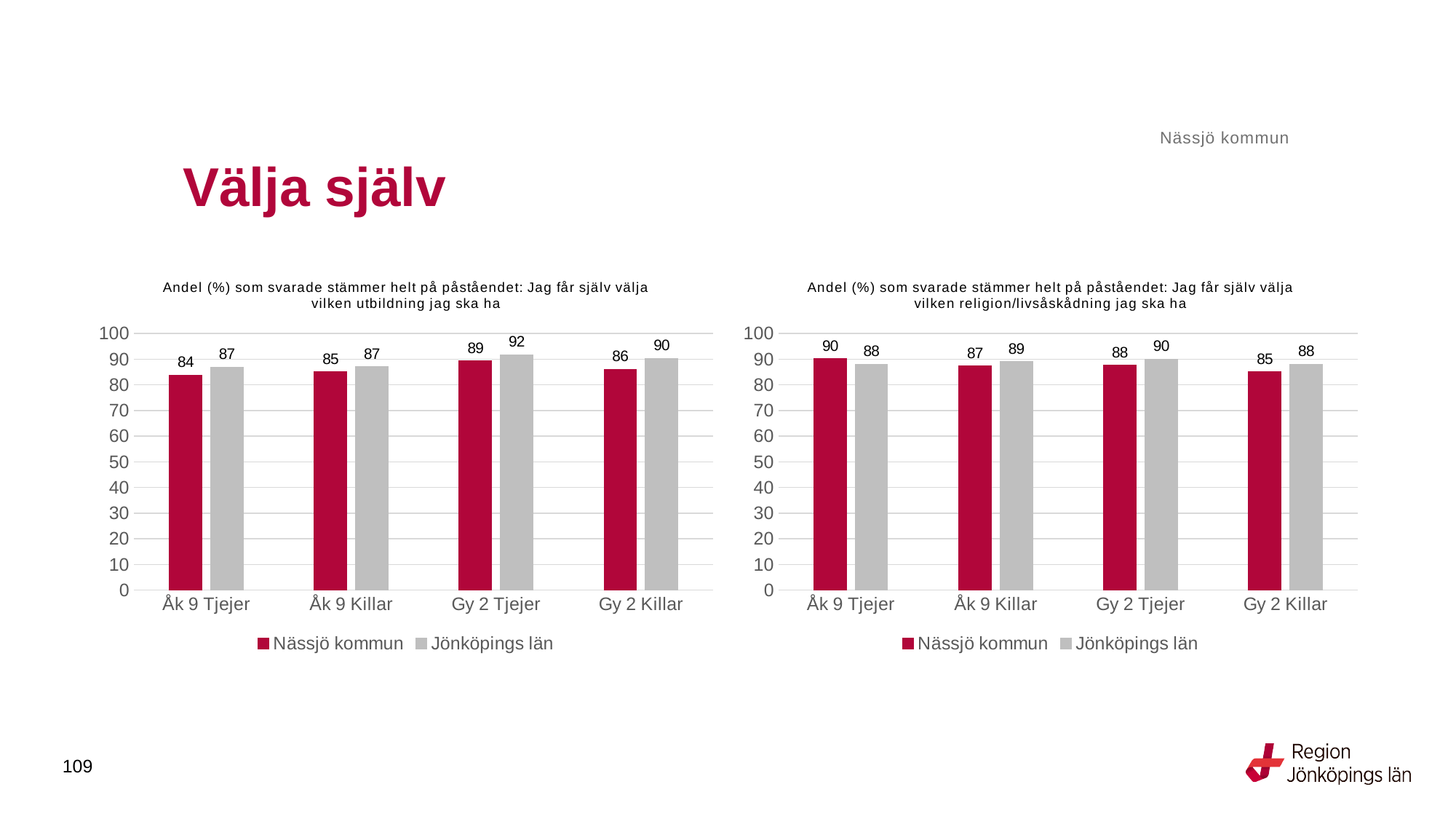
In the right chart (about choosing religion), what is the value for Nässjö kommun for Åk 9 Tjejer? 90 In the right chart (about choosing religion), what is the value for Jönköpings län for Gy 2 Killar? 88 In the left chart (about choosing education), which category has the highest value for Nässjö kommun? Gy 2 Tjejer How many categories are shown on the x axis of the left chart? 4 In the right chart, which colour represents Jönköpings län? Grey In the left chart (about choosing education), what is the difference between Jönköpings län and Nässjö kommun for Gy 2 Killar? 4 How many series does the legend of the right chart list? 2 In the right chart (about choosing religion), which category has the lowest value for Nässjö kommun? Gy 2 Killar What kind of chart is the left chart? Bar chart In the left chart (about choosing education), what is the value for Jönköpings län for Gy 2 Tjejer? 92 In the right chart (about choosing religion), which is larger for Åk 9 Tjejer: Nässjö kommun or Jönköpings län? Nässjö kommun In the left chart (about choosing education), what is the value for Nässjö kommun for Åk 9 Tjejer? 84